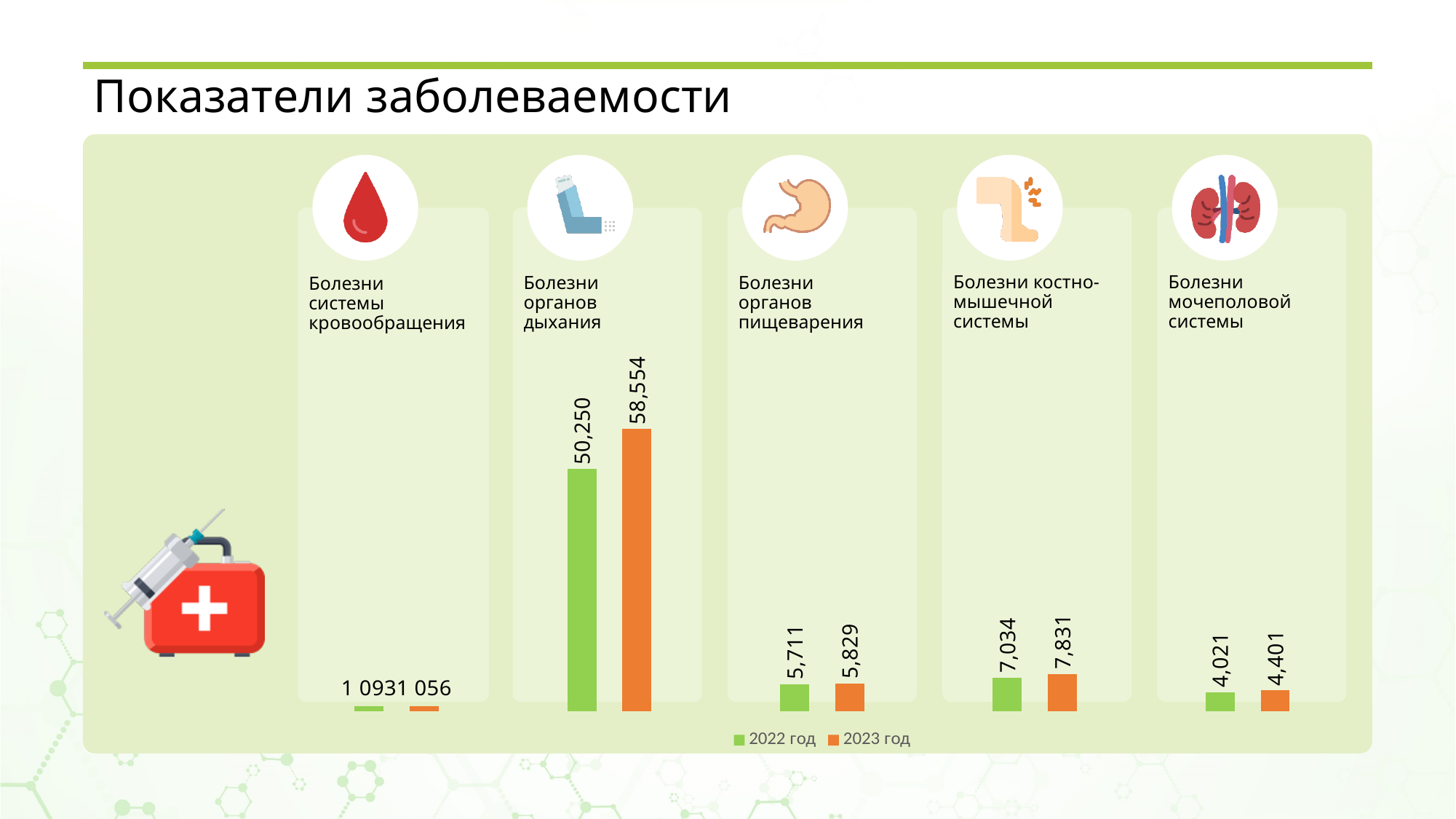
How many series does the legend list? 2 What is the 2023 год value for Болезни органов дыхания? 58,554 What kind of chart is shown on the slide? bar chart What is the difference between the 2023 год and 2022 год values for Болезни костно-мышечной системы? 797 What is the difference between the 2023 год and 2022 год values for Болезни органов дыхания? 8,304 What is the 2022 год value for Болезни мочеполовой системы? 4,021 What is the 2023 год value for Болезни костно-мышечной системы? 7,831 How many disease categories are shown in the chart? 5 What is the 2022 год value for Болезни органов дыхания? 50,250 Which category has the highest 2023 год value? Болезни органов дыхания Which is larger for Болезни органов пищеварения: the 2022 год value or the 2023 год value? 2023 год What is the title of the slide containing the chart? Показатели заболеваемости